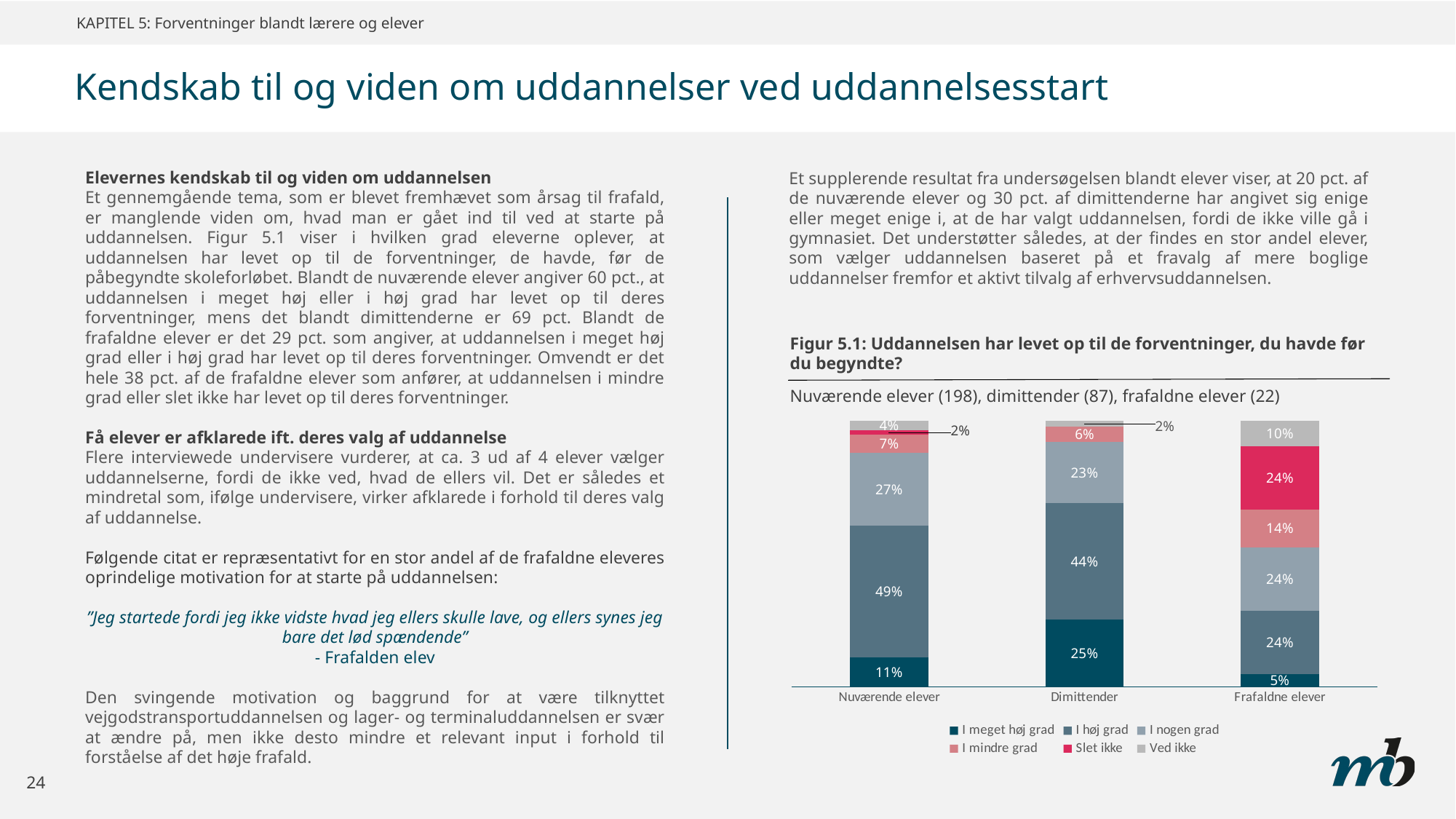
Which group has the lowest value for 'I høj grad'? Frafaldne elever How many series does the chart legend list? 6 What is the value for 'I høj grad' among Nuværende elever? 49% What kind of chart is shown in Figur 5.1? Stacked bar chart What is the value for 'Slet ikke' among Frafaldne elever? 24% Which is larger: 'I nogen grad' for Nuværende elever or 'I nogen grad' for Dimittender? Nuværende elever What is the value for 'I meget høj grad' among Dimittender? 25% How many categories (groups of students) are shown on the x axis of the chart? 3 Which group has the highest value for 'I meget høj grad'? Dimittender What is the difference between the 'I høj grad' values for Nuværende elever and Dimittender? 5 percentage points What is the value for 'Ved ikke' among Frafaldne elever? 10% What is the value for 'I mindre grad' among Nuværende elever? 7%